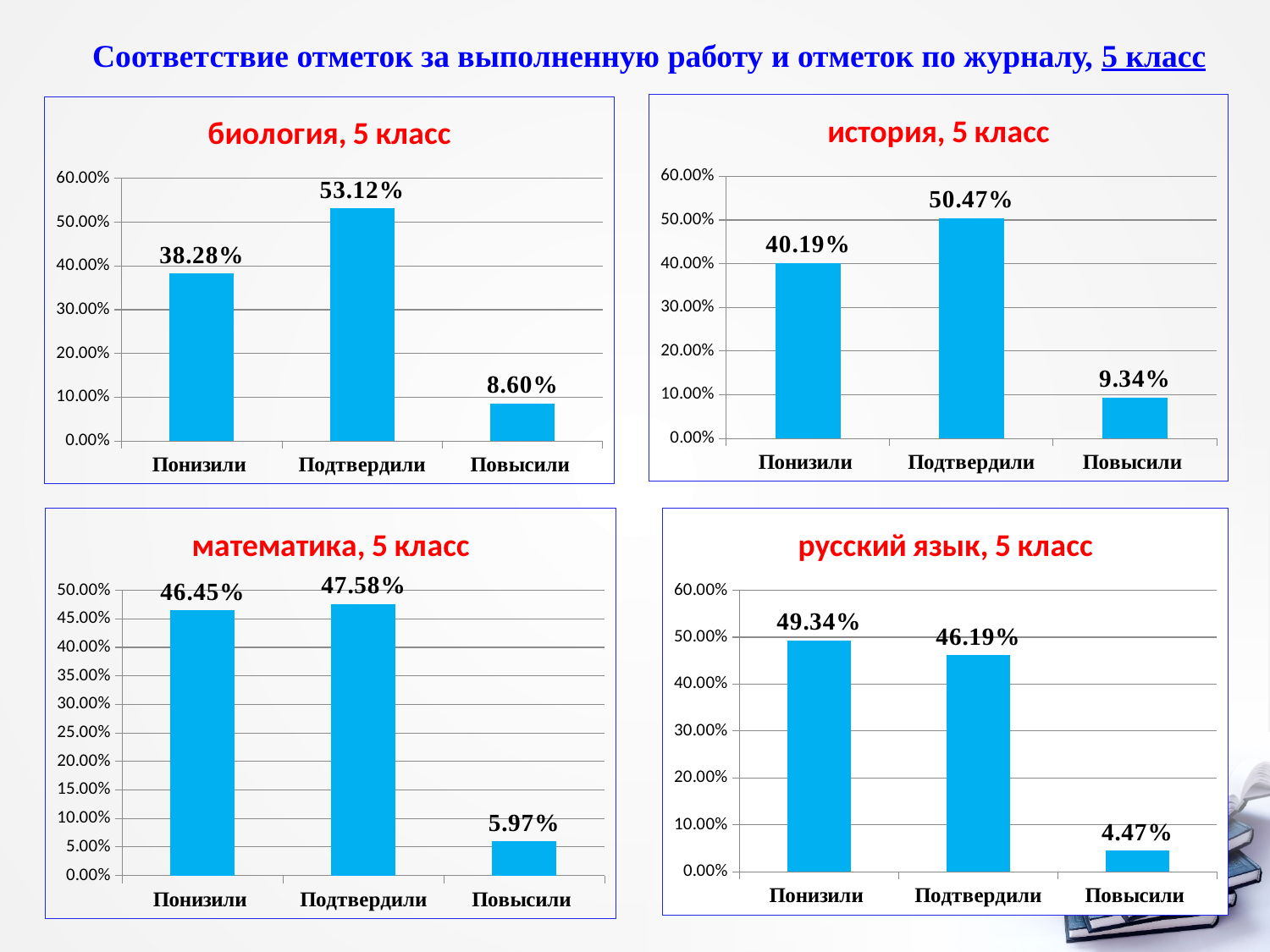
In the chart titled "математика, 5 класс", which is larger: the value for Подтвердили or the value for Повысили? Подтвердили In the chart titled "история, 5 класс", what is the difference between the values for Подтвердили and Понизили? 10.28% In the chart titled "история, 5 класс", is the value for Понизили greater or less than 30.00%? greater In the chart titled "биология, 5 класс", which category has the lowest value? Повысили What kind of chart is the chart titled "русский язык, 5 класс"? bar chart In the chart titled "русский язык, 5 класс", what is the difference between the values for Понизили and Повысили? 44.87% In the chart titled "биология, 5 класс", what is the value for Подтвердили? 53.12% How many charts are shown on the slide? 4 In the chart titled "русский язык, 5 класс", which category has the highest value? Понизили How many categories are shown in the chart titled "биология, 5 класс"? 3 In the chart titled "математика, 5 класс", what is the value for Понизили? 46.45% In the chart titled "история, 5 класс", what is the value for Повысили? 9.34%